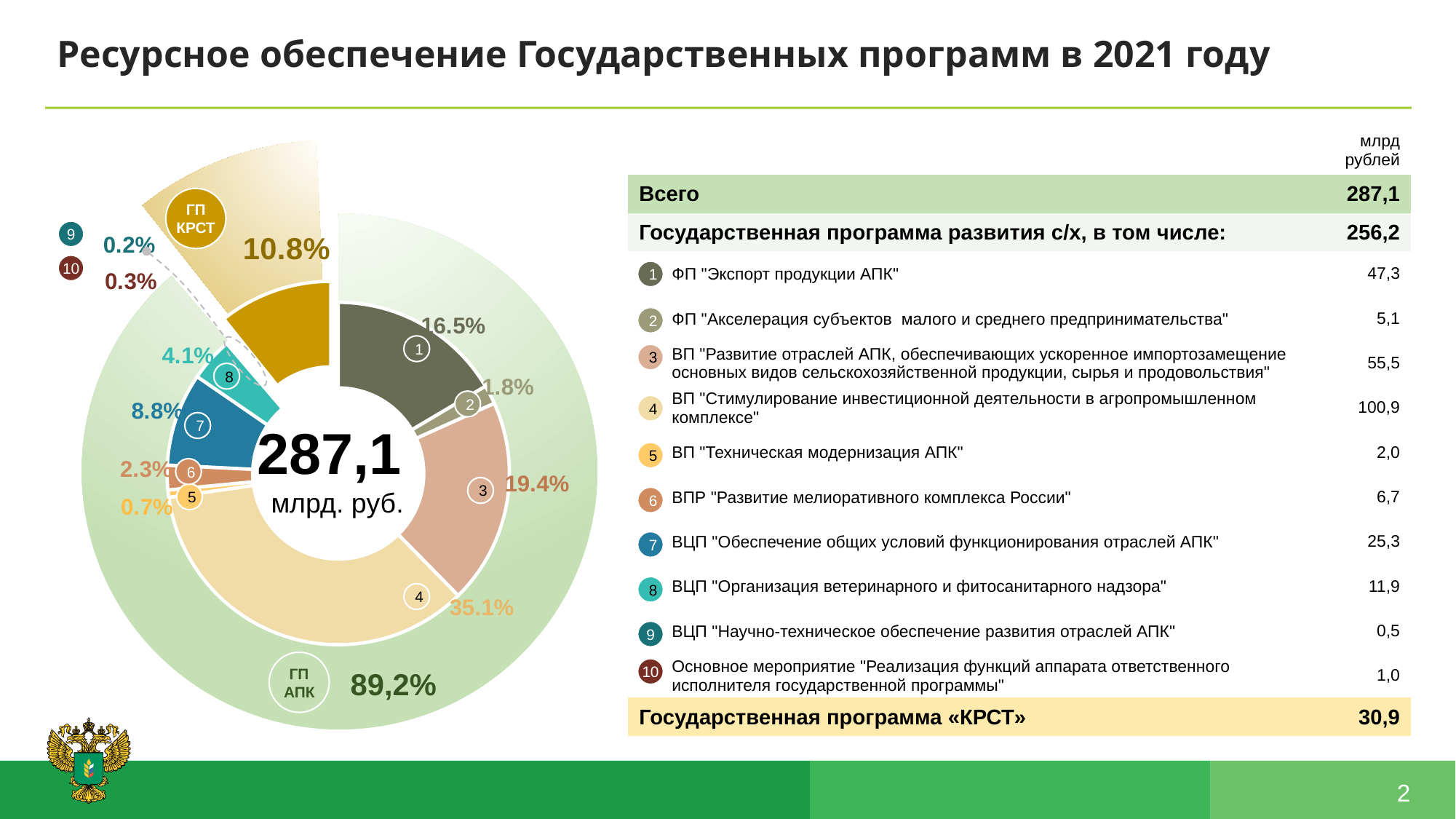
What percentage is shown for segment 7 of the pie chart? 8.8% Which segment has the larger share in the pie chart, segment 1 or segment 3? segment 3 What percentage is shown for segment 4 of the pie chart? 35.1% By how many percentage points does segment 4 exceed segment 3 in the pie chart? 15.7 percentage points What total value is printed in the centre of the pie chart? 287,1 млрд. руб. Which numbered segment of the pie chart has the largest share? 4 How many numbered segments does the pie chart have? 10 Which numbered segment of the pie chart has the smallest share? 9 What colour is segment 7 in the pie chart? blue What kind of chart is shown on the left of the slide? pie chart What share does the outer ring show for ГП КРСТ? 10.8% What share does the outer ring show for ГП АПК? 89,2%